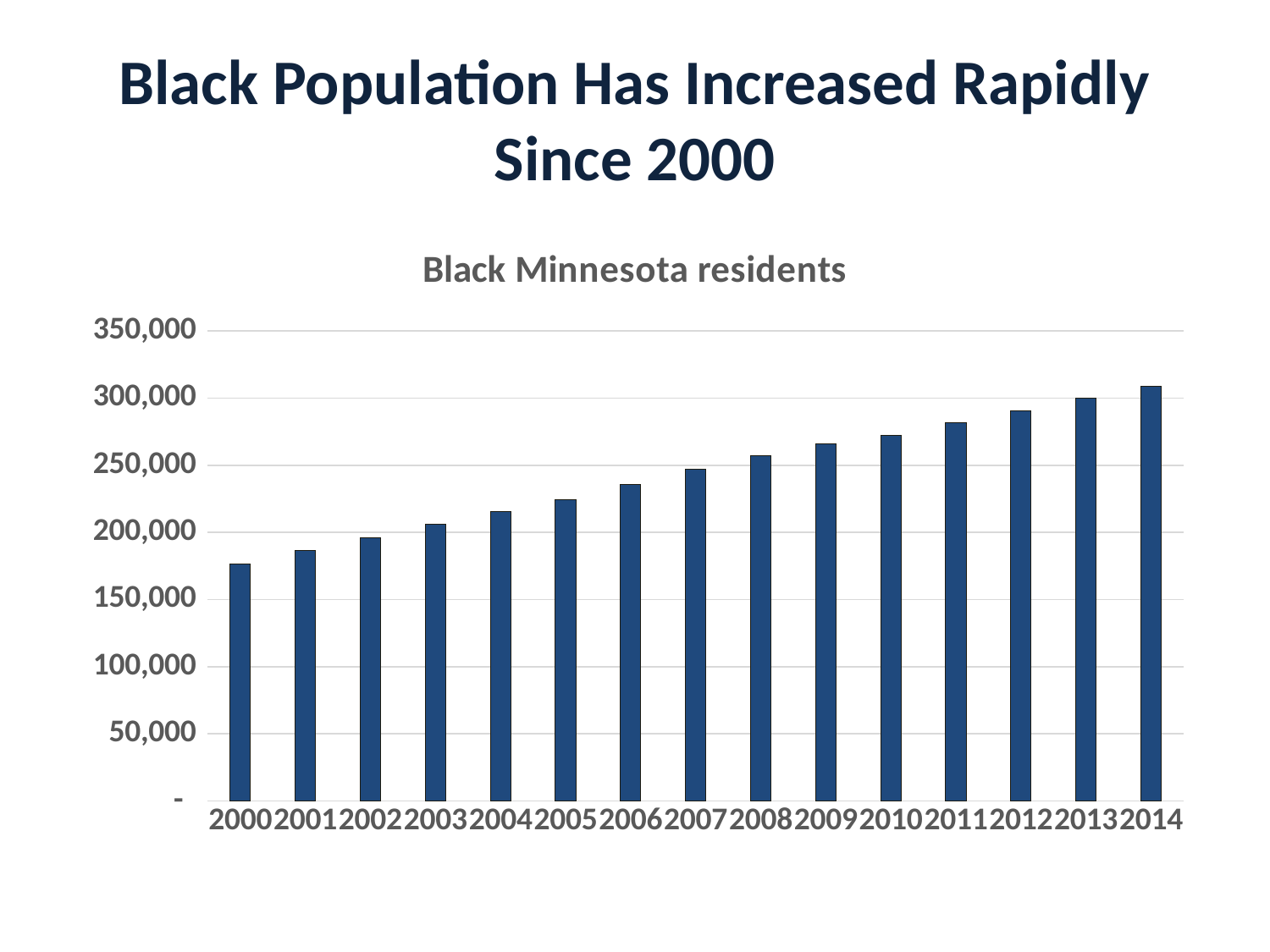
Is the value for 2004 greater or less than 250,000? less What is the title of the chart? Black Minnesota residents Is the value for 2000 greater or less than 200,000? less How many years are shown on the x axis of the chart? 15 Which is larger, the value for 2005 or the value for 2010? 2010 What kind of chart is shown on the slide? bar chart Which year has the highest number of Black Minnesota residents? 2014 Is the value for 2008 greater or less than 250,000? greater What is the highest value labelled on the vertical axis? 350,000 Which year has the lowest number of Black Minnesota residents? 2000 Do the values rise or fall from 2000 to 2014? rise